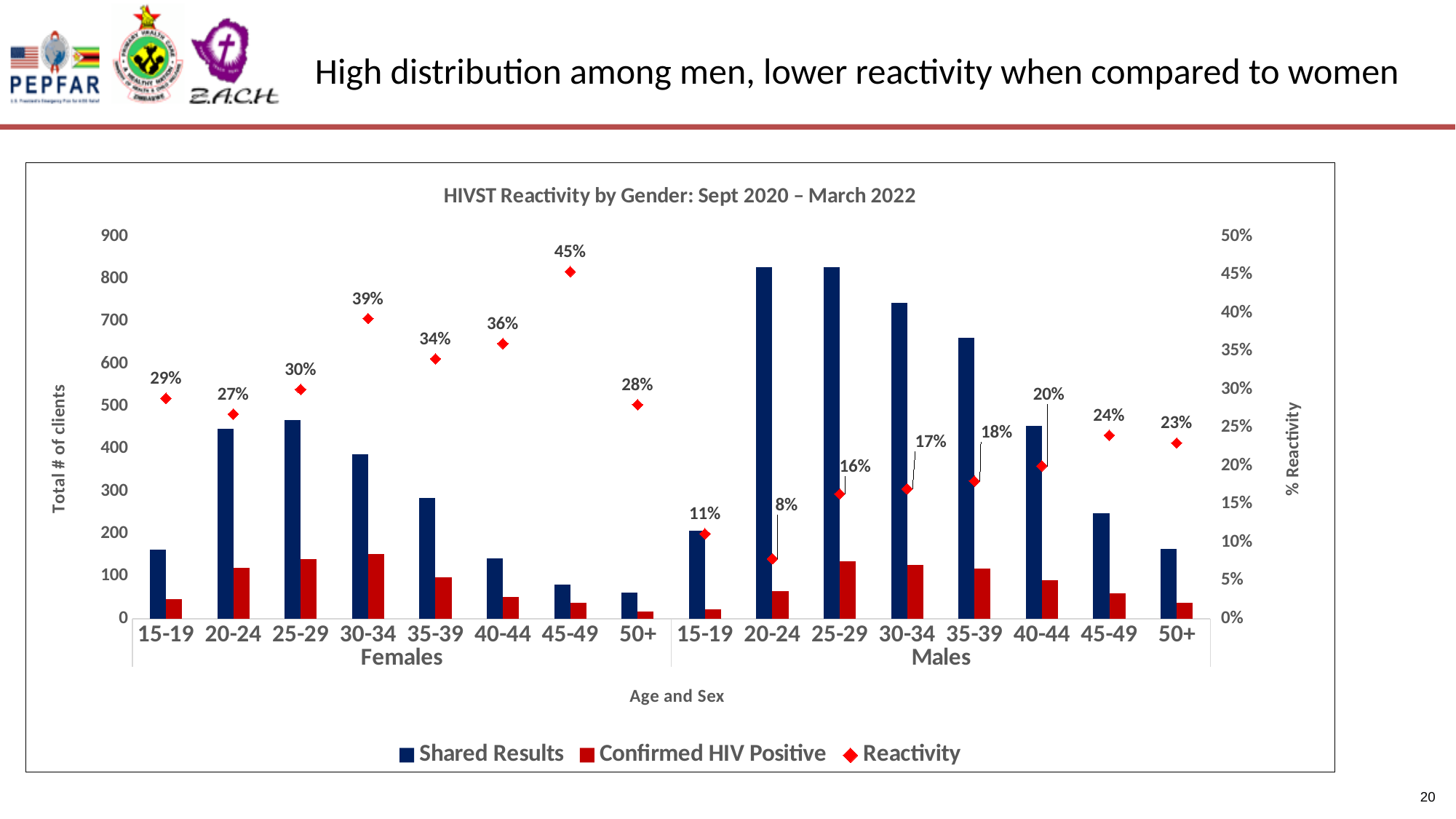
What is the Reactivity value for Females aged 45-49? 45% What is the Reactivity value for Males aged 45-49? 24% Is the Shared Results value for Females aged 45-49 greater or less than 100? less Which age and sex group has the highest Reactivity? Females 45-49 What is the Reactivity value for Females aged 30-34? 39% What is the title of the chart? HIVST Reactivity by Gender: Sept 2020 – March 2022 What is the Reactivity value for Males aged 20-24? 8% Which age and sex group has the lowest Reactivity? Males 20-24 How many series does the legend list? 3 Which has a higher Reactivity: Females aged 15-19 or Males aged 15-19? Females 15-19 What is the difference in Reactivity between Females aged 45-49 and Males aged 45-49? 21% Is the Shared Results value for Males aged 20-24 greater or less than 800? greater